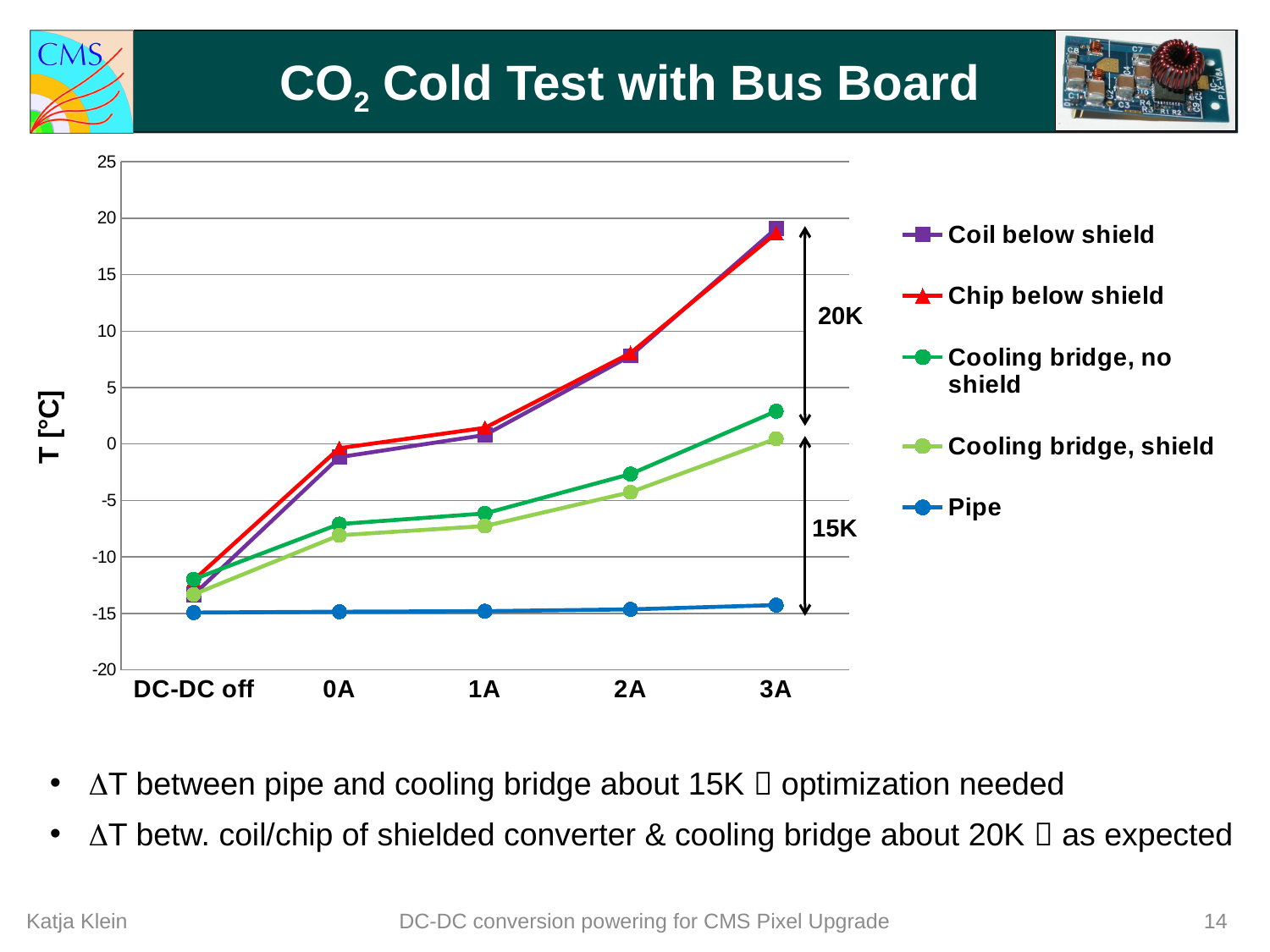
Is the value for Pipe at 1A greater or less than -10? less Which series has the lowest temperature at 3A? Pipe Does the Chip below shield series rise or fall from DC-DC off to 3A? rise How many categories are shown on the x axis? 5 At 2A, which is larger: Cooling bridge, no shield or Cooling bridge, shield? Cooling bridge, no shield Which series has the highest temperature at 3A? Coil below shield Is the value for Coil below shield at 3A greater or less than 15? greater What is the label of the y axis? T [°C] Is the value for Cooling bridge, no shield at 2A greater or less than 0? less What is the title of the slide containing the chart? CO2 Cold Test with Bus Board How many series does the legend list? 5 What kind of chart is shown on the slide? line chart